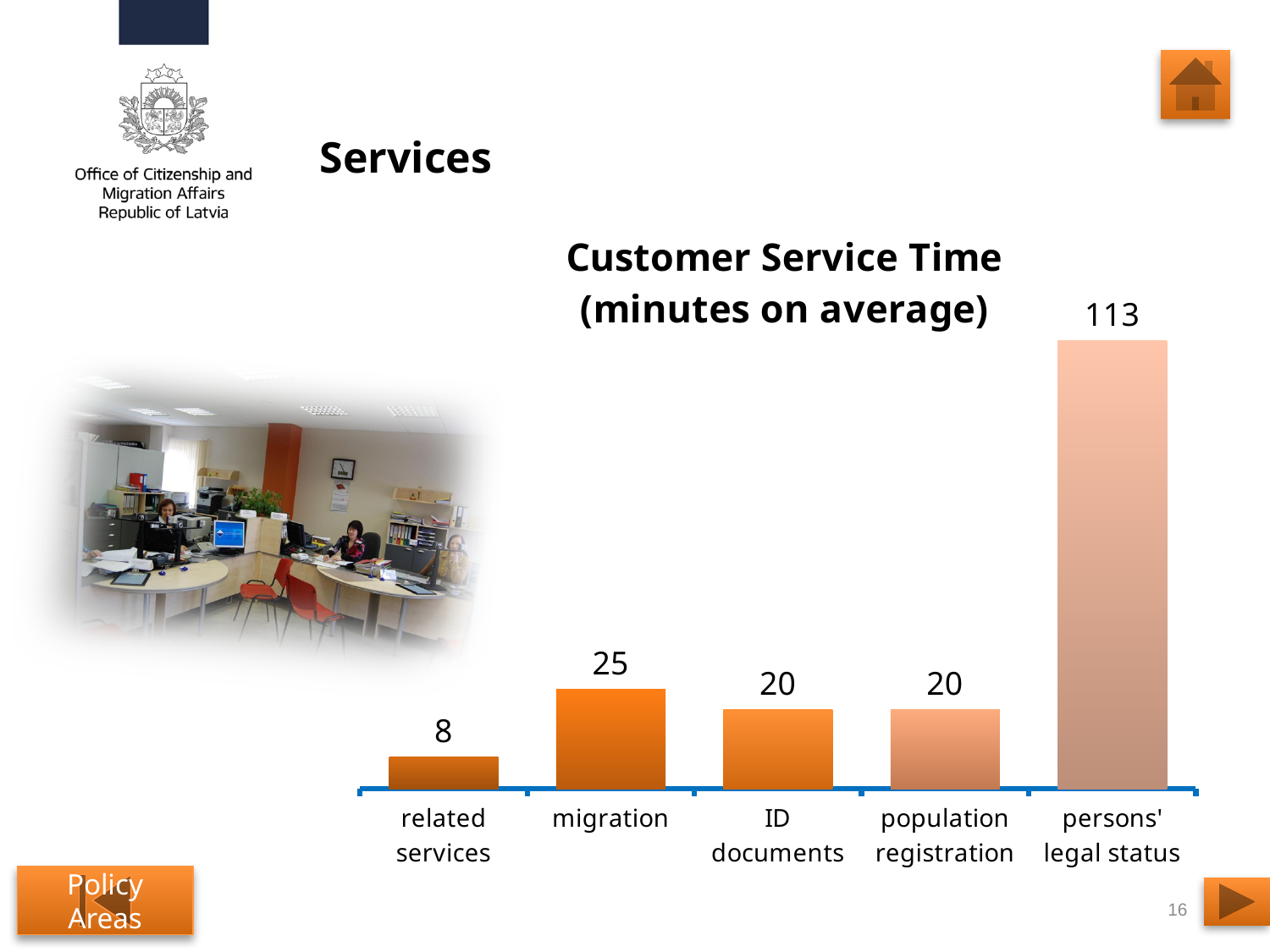
What is the average customer service time for migration? 25 Which has a longer average service time, migration or ID documents? migration What is the difference in average service time between migration and related services? 17 What is the average customer service time for ID documents? 20 What is the difference in average service time between persons' legal status and migration? 88 What is the title of the chart? Customer Service Time (minutes on average) What is the average customer service time for related services? 8 How many categories are shown in the chart? 5 What is the average customer service time for persons' legal status? 113 Which category has the highest average customer service time? persons' legal status Which category has the lowest average customer service time? related services What type of chart is shown on the slide? bar chart